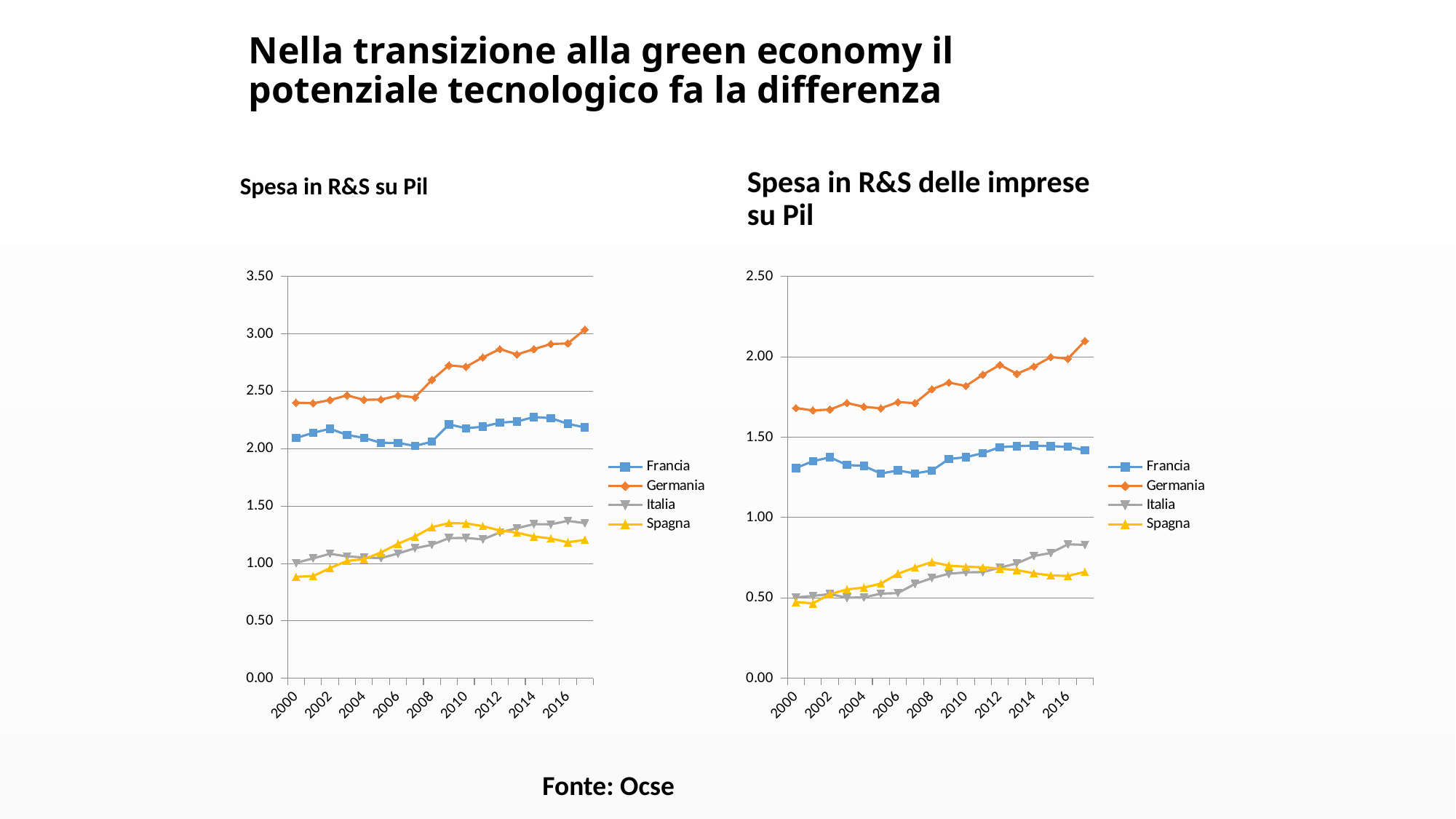
In the right chart, 'Spesa in R&S delle imprese su Pil', is the value for Francia in 2000 greater or less than 1.50? less In the left chart, 'Spesa in R&S su Pil', is the value for Spagna in 2000 greater or less than 1.00? less In the right chart, 'Spesa in R&S delle imprese su Pil', which country has the lowest value in 2016? Spagna In the left chart, 'Spesa in R&S su Pil', which country has the highest value in 2016? Germania In the right chart, 'Spesa in R&S delle imprese su Pil', is the value for Germania in 2016 greater or less than 1.50? greater In the right chart, 'Spesa in R&S delle imprese su Pil', does the Germania line generally rise or fall from 2000 to 2016? rise What kind of chart is the left chart, 'Spesa in R&S su Pil'? line chart What is the source cited at the bottom of the slide for the charts? Ocse In the left chart, 'Spesa in R&S su Pil', which is larger in 2016: Italia or Spagna? Italia How many series does the legend of the right chart, 'Spesa in R&S delle imprese su Pil', list? 4 In the right chart, 'Spesa in R&S delle imprese su Pil', which is larger in 2000: Francia or Italia? Francia